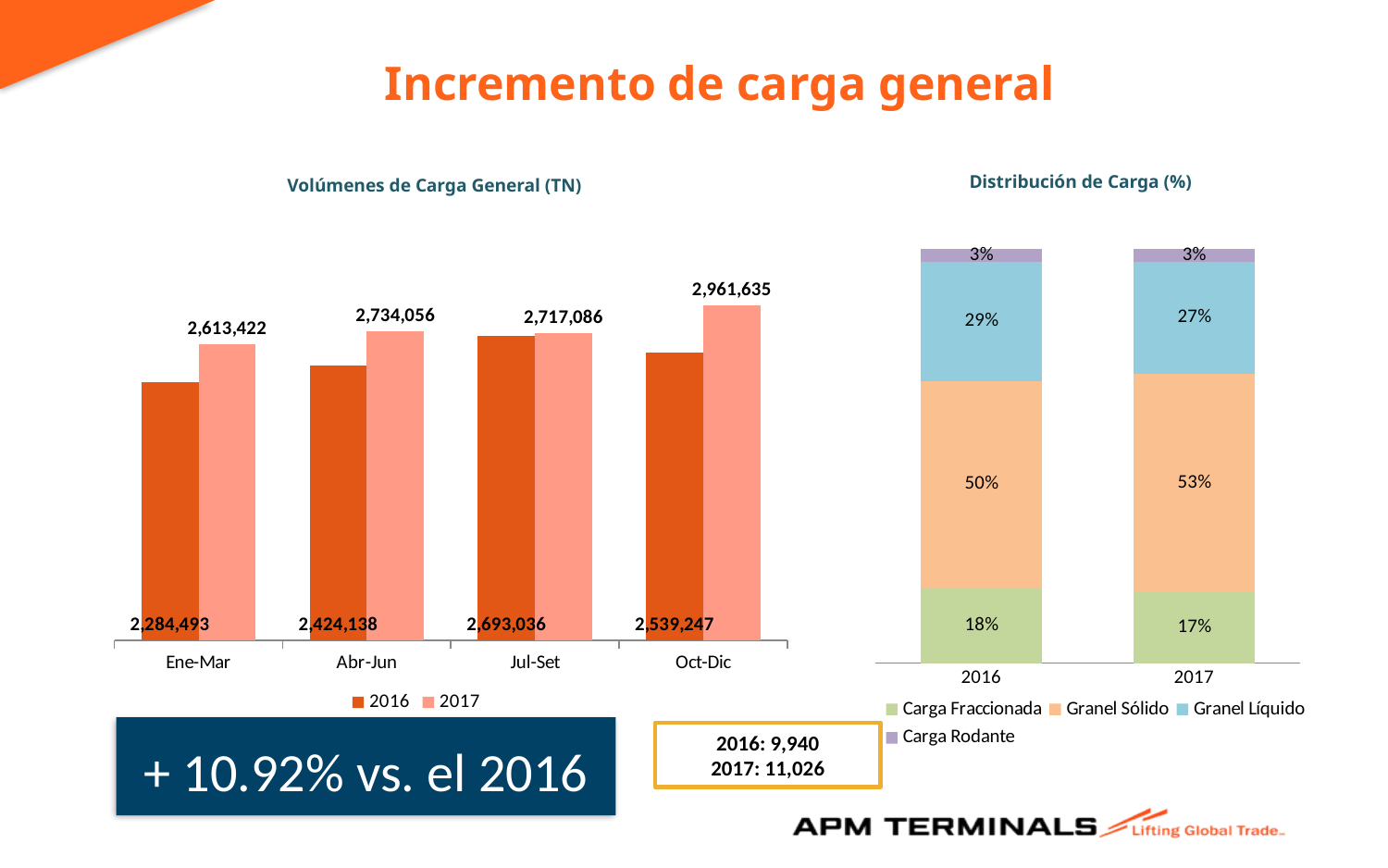
In the 'Volúmenes de Carga General (TN)' chart, which quarter has the highest 2017 value? Oct-Dic In the 'Volúmenes de Carga General (TN)' chart, what is the difference between the 2017 and 2016 values for Jul-Set? 24,050 How many quarters are shown on the x axis of the 'Volúmenes de Carga General (TN)' chart? 4 How many series does the legend of the 'Distribución de Carga (%)' chart list? 4 How many series does the legend of the 'Volúmenes de Carga General (TN)' chart list? 2 What kind of chart is 'Distribución de Carga (%)'? Stacked bar chart In the 'Volúmenes de Carga General (TN)' chart, what is the 2016 value for Ene-Mar? 2,284,493 In the 'Volúmenes de Carga General (TN)' chart, what is the 2017 value for Oct-Dic? 2,961,635 In the 'Distribución de Carga (%)' chart, what is the share of Granel Sólido in 2017? 53% In the 'Volúmenes de Carga General (TN)' chart, which quarter has the lowest 2016 value? Ene-Mar In the 'Distribución de Carga (%)' chart, which category has the smallest share in 2016? Carga Rodante In the 'Volúmenes de Carga General (TN)' chart, which is larger: the 2016 value for Jul-Set or the 2016 value for Oct-Dic? Jul-Set